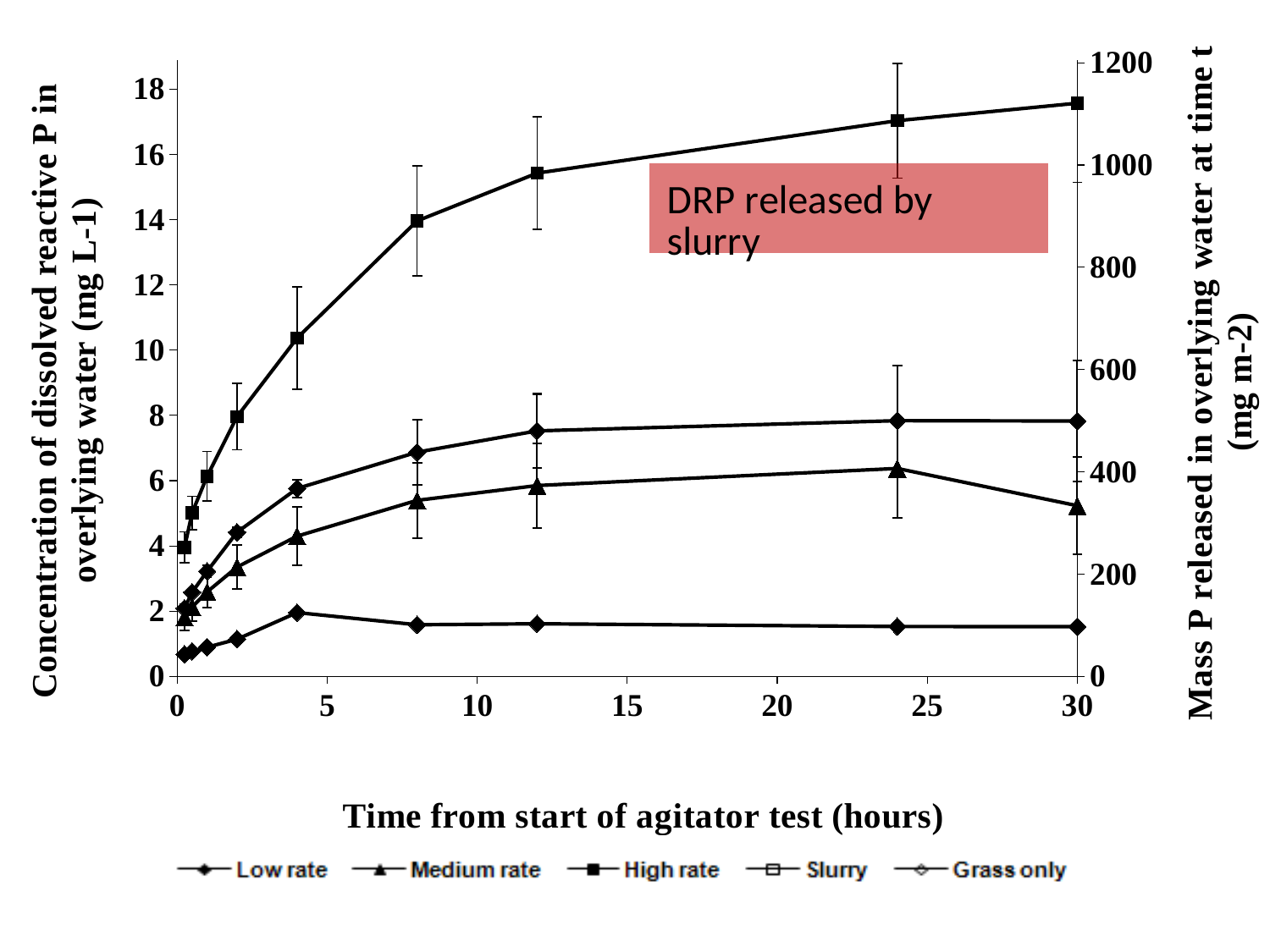
How many series does the legend list? 5 What text appears in the red box on the chart? DRP released by slurry Is the value for Medium rate at 30 hours greater or less than 6 on the left axis? less Is the value for High rate at 30 hours greater or less than 16 on the left axis? greater At 30 hours, which is larger: the High rate value or the Medium rate value? High rate What kind of chart is shown on the slide? line chart Which series has the highest values across the chart? High rate Is the value for High rate at 8 hours greater or less than 12 on the left axis? greater Does the High rate series rise or fall as time increases from 0 to 30 hours? rise What is the label of the x axis? Time from start of agitator test (hours)